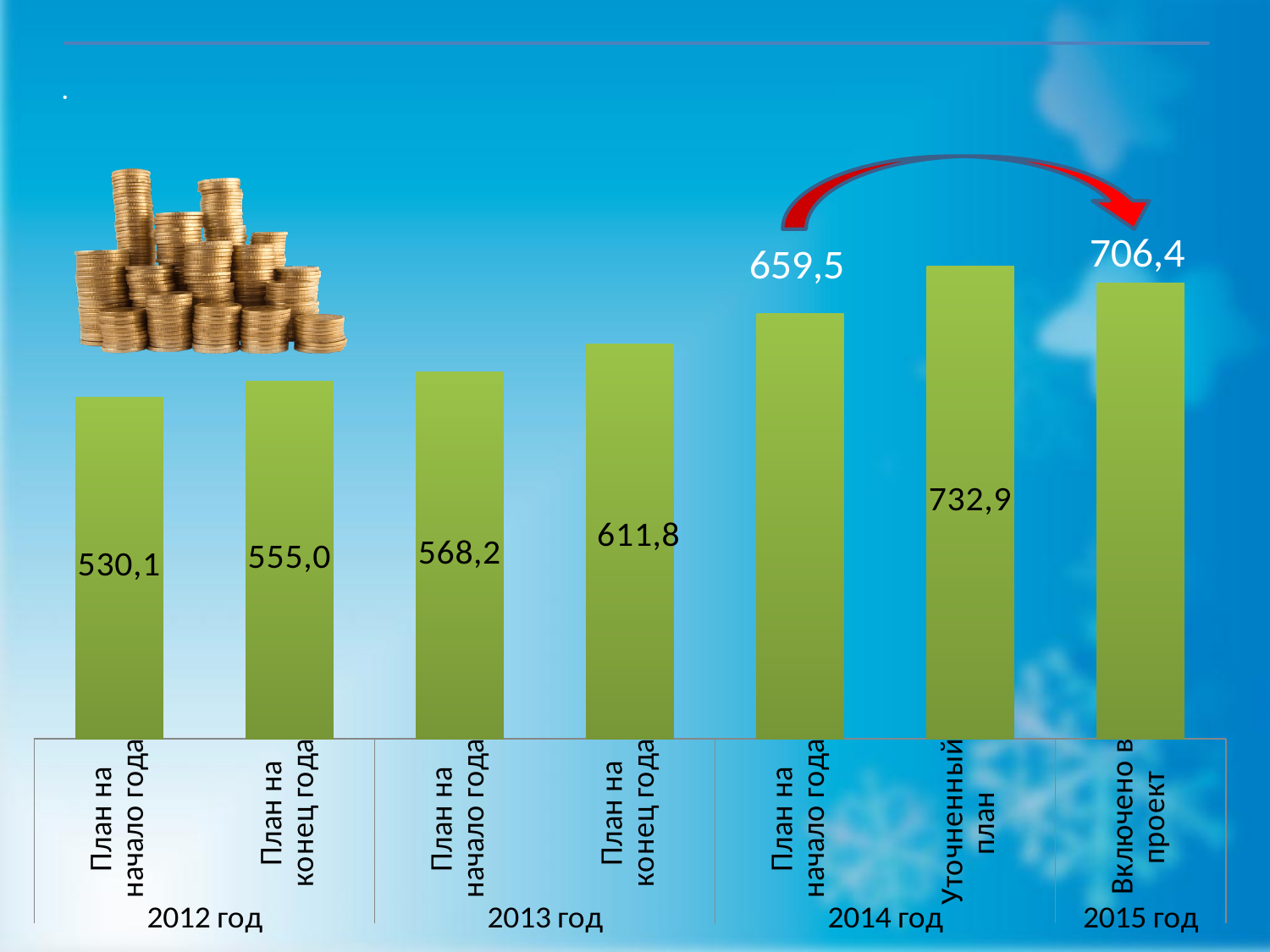
Which is larger: "План на начало года" in 2014 год or "План на конец года" in 2013 год? План на начало года in 2014 год What is the value for "Включено в проект" in 2015 год? 706,4 What kind of chart is shown on the slide? Bar chart What is the difference between "План на конец года" and "План на начало года" in 2012 год? 24,9 What is the difference between "Уточненный план" in 2014 год and "Включено в проект" in 2015 год? 26,5 Which bar has the highest value? Уточненный план (2014 год) How many bars are plotted on the chart? 7 What is the value for "План на конец года" in 2013 год? 611,8 What is the value for "План на начало года" in 2012 год? 530,1 Do the values rise or fall from "План на начало года" in 2012 год to "Уточненный план" in 2014 год? Rise What is the value for "Уточненный план" in 2014 год? 732,9 Which bar has the lowest value? План на начало года (2012 год)